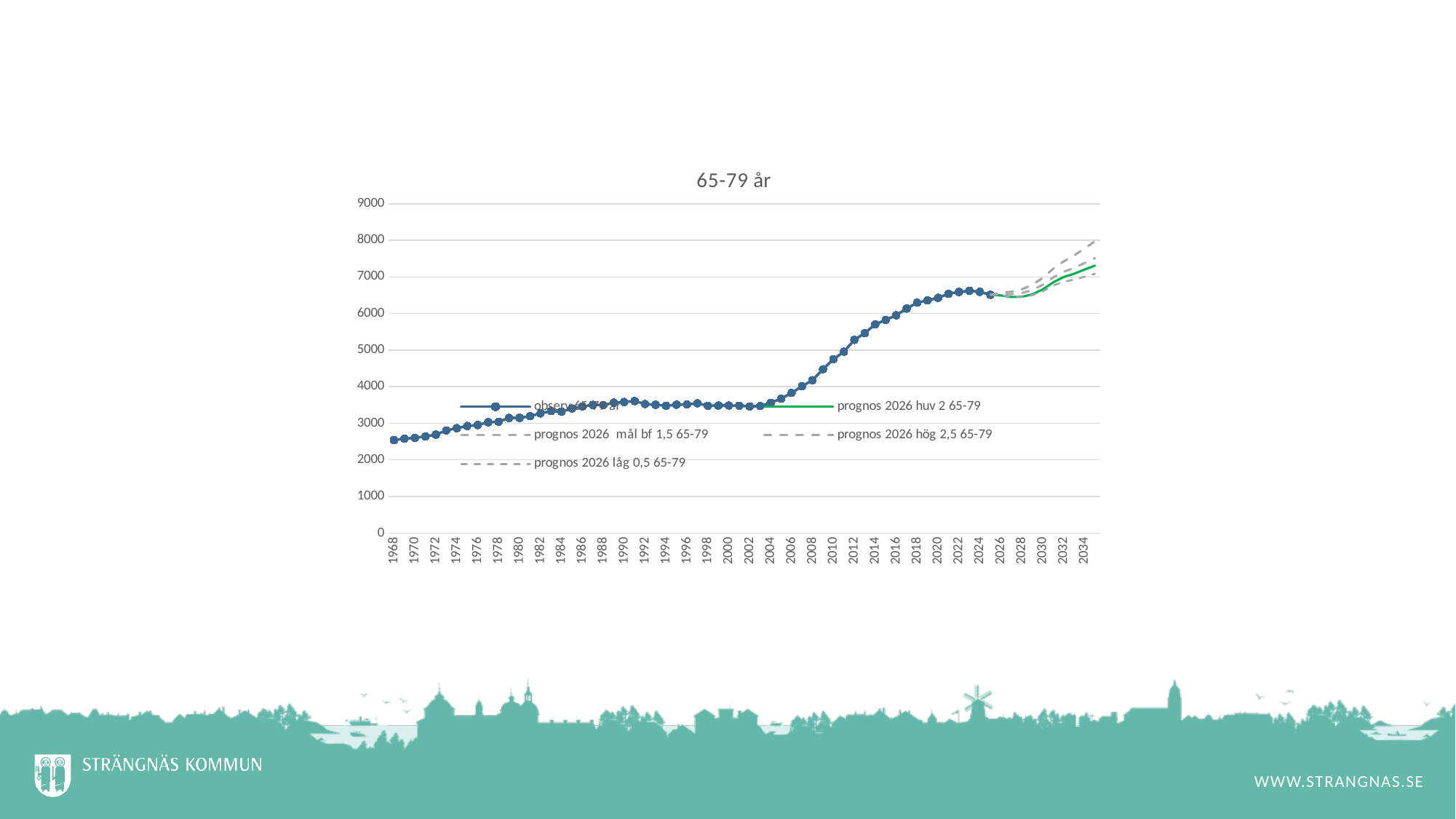
Is the observed value for 2012 greater or less than 5000? greater Is the observed value for 1990 greater or less than 4000? less How many series does the legend list? 5 What is the title of the chart? 65-79 år Which year has the lowest observed value? 1968 What is the highest value shown on the vertical axis? 9000 Do the observed values generally rise or fall from 1968 to 2024? rise Is the observed value for 2024 greater or less than 6000? greater What kind of chart is shown on the slide? line chart Which is larger, the observed value for 1968 or the observed value for 2020? 2020